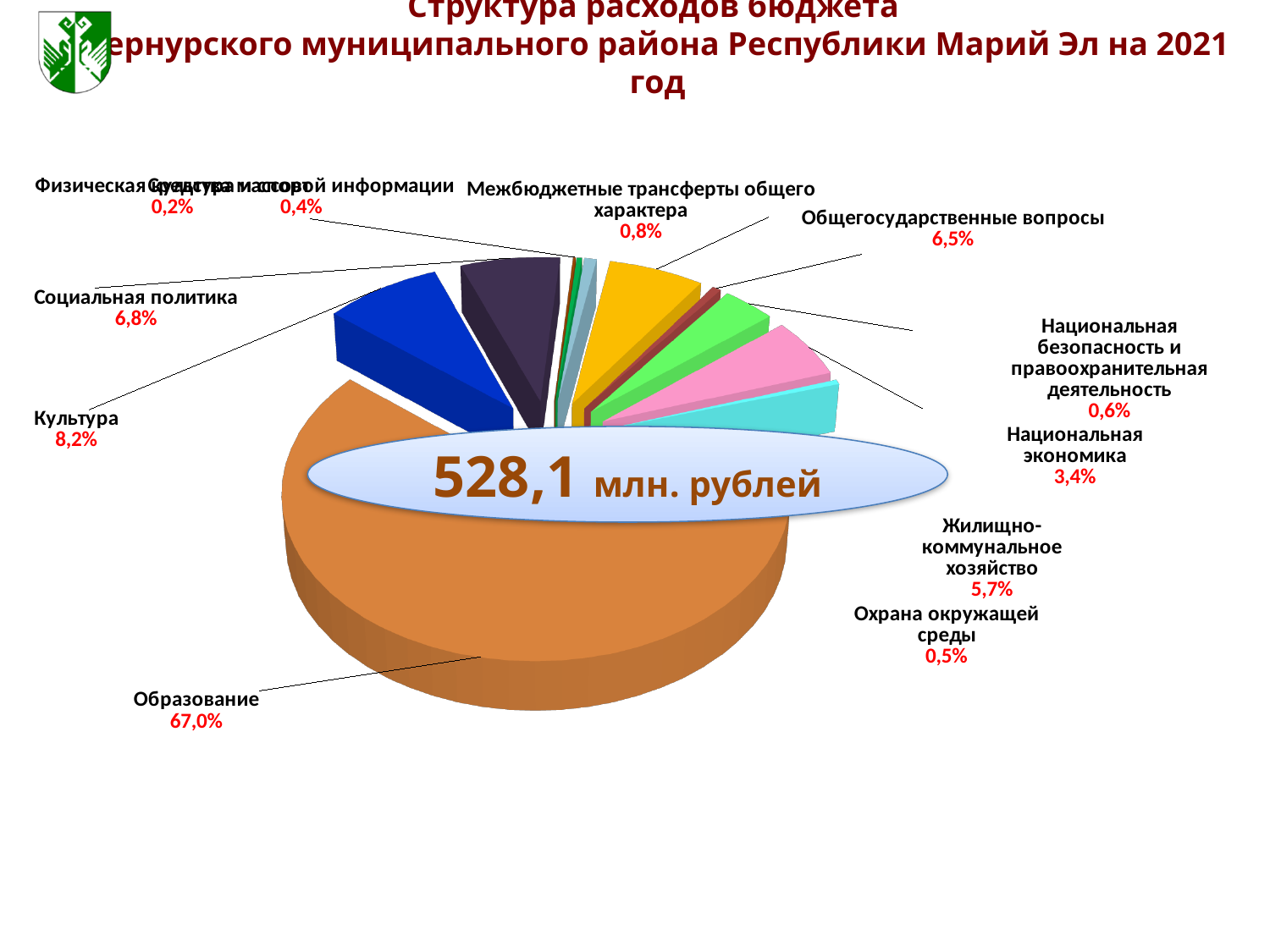
What is the difference in percentage points between the shares of Культура and Социальная политика? 1,4 What share of the budget expenditure goes to Социальная политика? 6,8% What share of the budget expenditure goes to Национальная экономика? 3,4% What kind of chart is shown on the slide? Pie chart What share of the budget expenditure goes to Жилищно-коммунальное хозяйство? 5,7% Which has a larger share: Межбюджетные трансферты общего характера or Национальная безопасность и правоохранительная деятельность? Межбюджетные трансферты общего характера Which category has the largest share of the budget expenditure? Образование What share of the budget expenditure goes to Образование? 67,0% Which has a larger share: Общегосударственные вопросы or Жилищно-коммунальное хозяйство? Общегосударственные вопросы What share of the budget expenditure goes to Культура? 8,2% What share of the budget expenditure goes to Охрана окружающей среды? 0,5% What total amount is shown in the centre of the pie chart? 528,1 млн. рублей